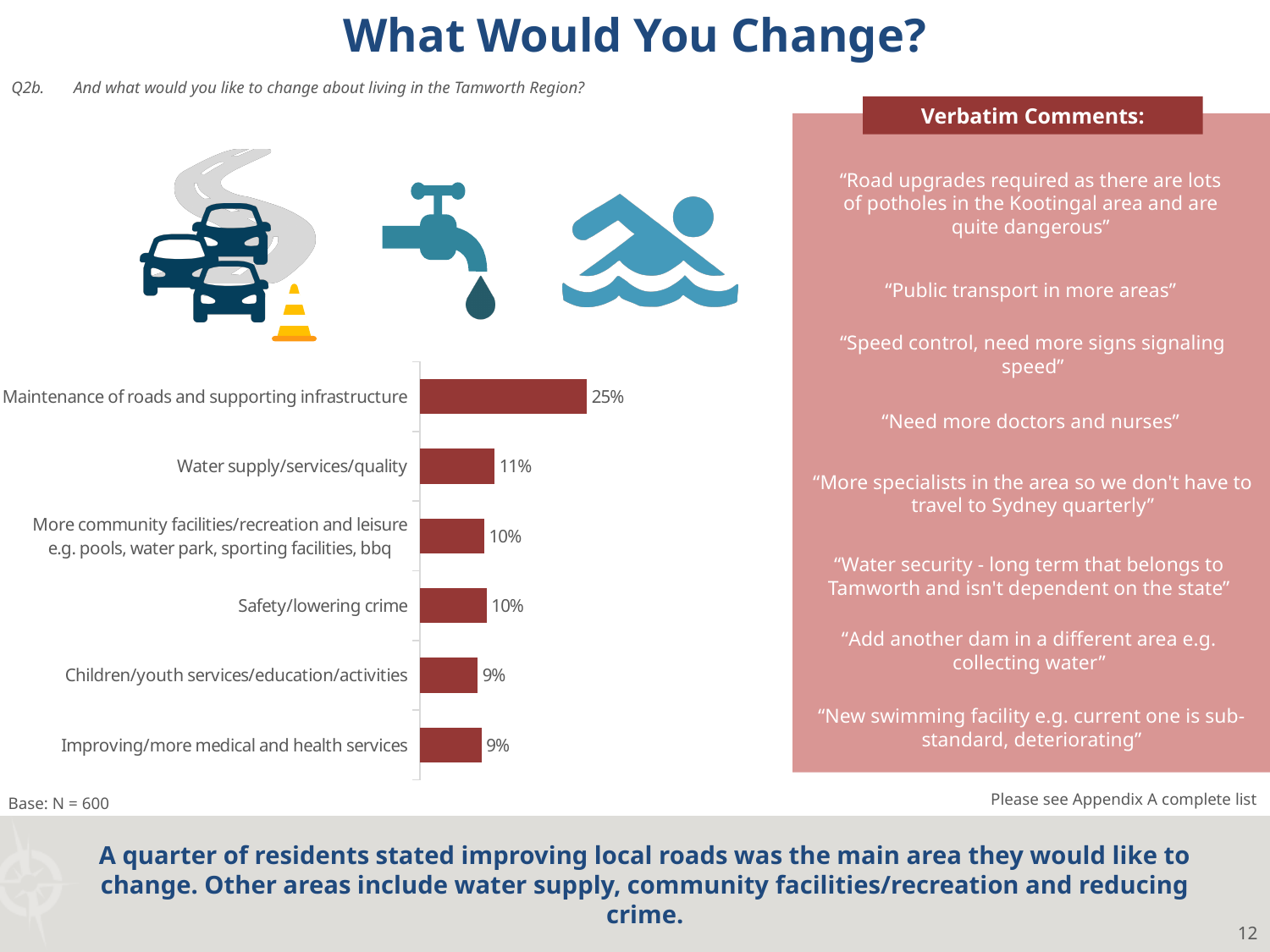
How many categories are shown in the bar chart? 6 Which is larger: the value for Water supply/services/quality or the value for Safety/lowering crime? Water supply/services/quality What is the value for Improving/more medical and health services? 9% What is the title of the slide containing the chart? What Would You Change? What is the value for Water supply/services/quality? 11% Which category has the highest value in the chart? Maintenance of roads and supporting infrastructure What is the difference between the value for maintenance of roads and the value for water supply/services/quality? 14% What type of chart is used on this slide? Bar chart What is the base sample size shown below the chart? N = 600 What percentage is shown for Safety/lowering crime? 10% What percentage of respondents mentioned maintenance of roads and supporting infrastructure? 25% What is the difference between the value for Water supply/services/quality and the value for Children/youth services/education/activities? 2%